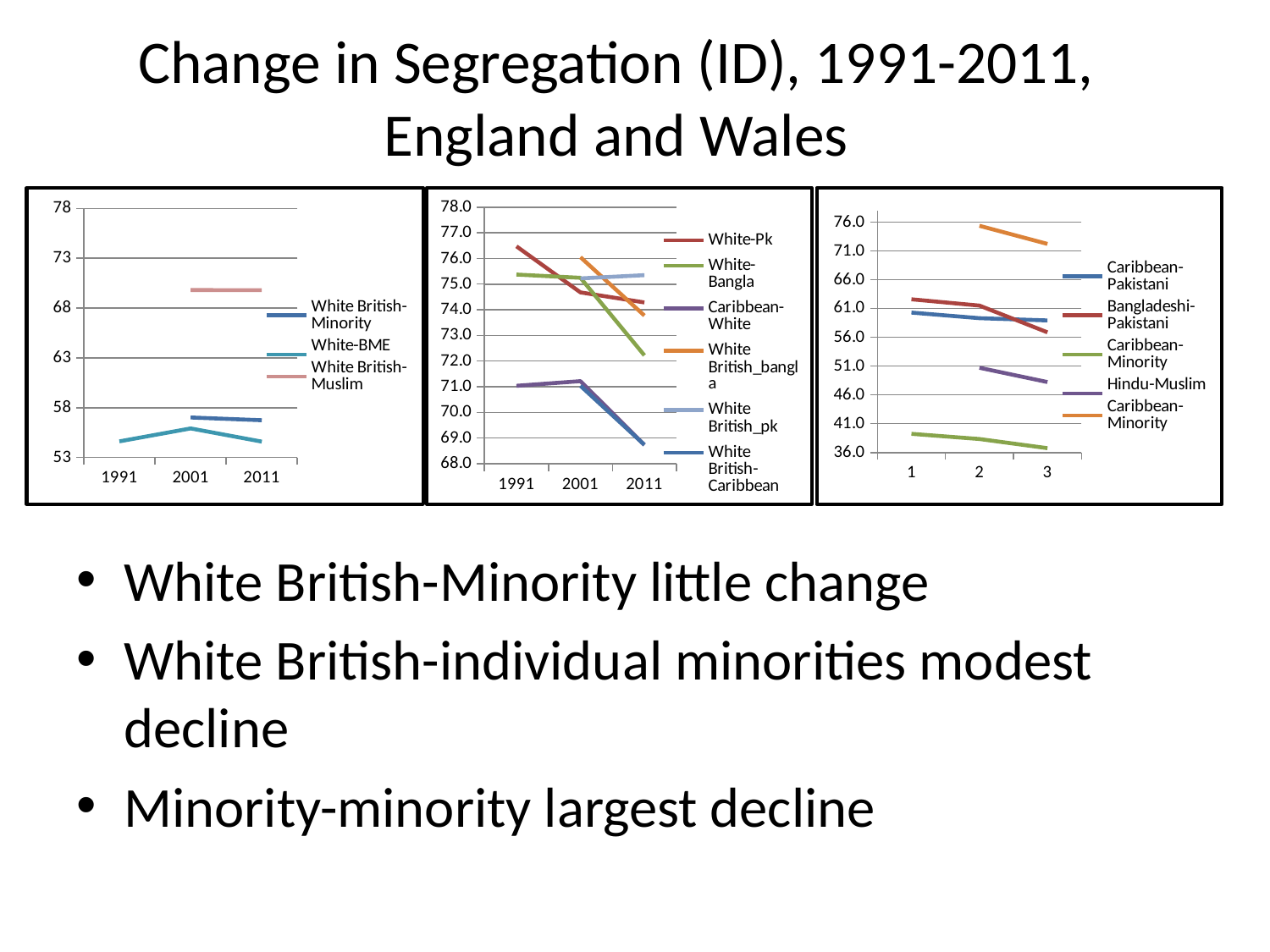
In the right chart, is the value for Hindu-Muslim at point 2 greater or less than 56.0? less In the middle chart, is the value for White-Bangla in 2011 greater or less than 73.0? less How many series does the legend of the left chart list? 3 What kind of chart is the left chart on the slide? line chart In the left chart, is the value for White British-Muslim in 2011 greater or less than 68? greater What are the x-axis labels of the right chart? 1, 2, 3 In the right chart, does the Bangladeshi-Pakistani line rise or fall from point 1 to point 3? fall In the middle chart, does the White-Bangla line rise or fall from 1991 to 2011? fall How many series does the legend of the middle chart list? 6 How many series does the legend of the right chart list? 5 How many points are on the x axis of the middle chart? 3